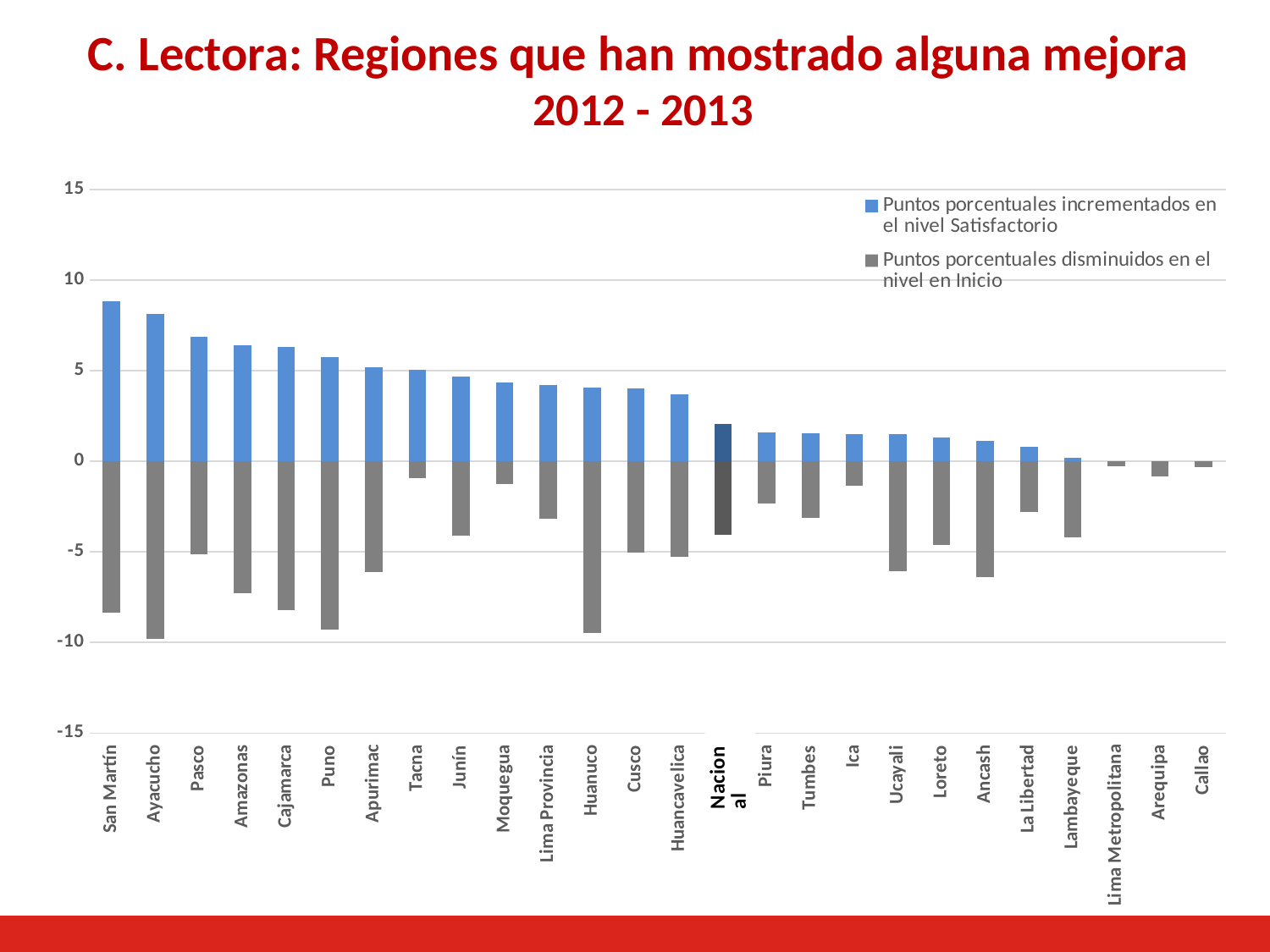
Is the value for Piura in the 'Puntos porcentuales incrementados en el nivel Satisfactorio' series greater or less than 5? less Is the value for Tacna in the 'Puntos porcentuales disminuidos en el nivel en Inicio' series greater or less than -5? greater Which has the larger value for 'Puntos porcentuales incrementados en el nivel Satisfactorio', San Martín or Piura? San Martín What colour represents 'Puntos porcentuales incrementados en el nivel Satisfactorio' in the legend? blue How many series does the legend list? 2 Is the value for Ayacucho in the 'Puntos porcentuales disminuidos en el nivel en Inicio' series greater or less than -5? less Which region has the highest value for 'Puntos porcentuales incrementados en el nivel Satisfactorio'? San Martín Which region shows the larger decrease in the 'Puntos porcentuales disminuidos en el nivel en Inicio' series, Amazonas or Tacna? Amazonas Do the values for 'Puntos porcentuales incrementados en el nivel Satisfactorio' rise or fall from left to right along the x axis? fall What kind of chart is shown on the slide? bar chart How many categories are shown along the x axis? 26